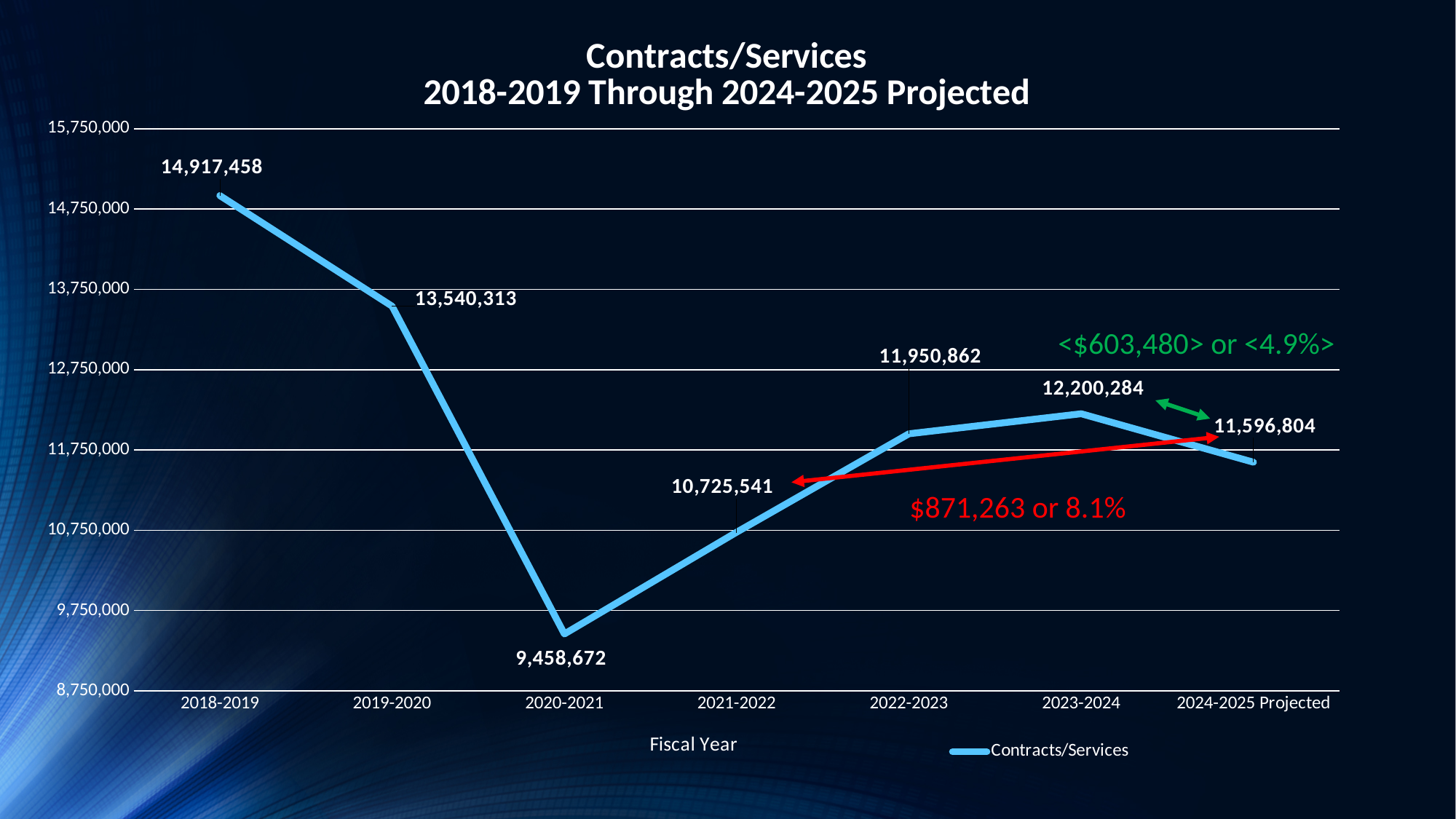
What is the difference between the 2018-2019 value and the 2019-2020 value? 1,377,145 What kind of chart is shown on the slide? line chart Does the Contracts/Services value rise or fall from 2018-2019 to 2020-2021? fall How many fiscal years are plotted on the chart? 7 What is the Contracts/Services value for 2020-2021? 9,458,672 Which fiscal year has the lowest Contracts/Services value? 2020-2021 Which fiscal year has the highest Contracts/Services value? 2018-2019 Is the value for 2021-2022 greater or less than 10,750,000? less What is the projected Contracts/Services value for 2024-2025? 11,596,804 Which is larger, the value for 2022-2023 or the value for 2023-2024? 2023-2024 What is the difference between the 2023-2024 value and the 2024-2025 Projected value? 603,480 What is the Contracts/Services value for 2018-2019? 14,917,458